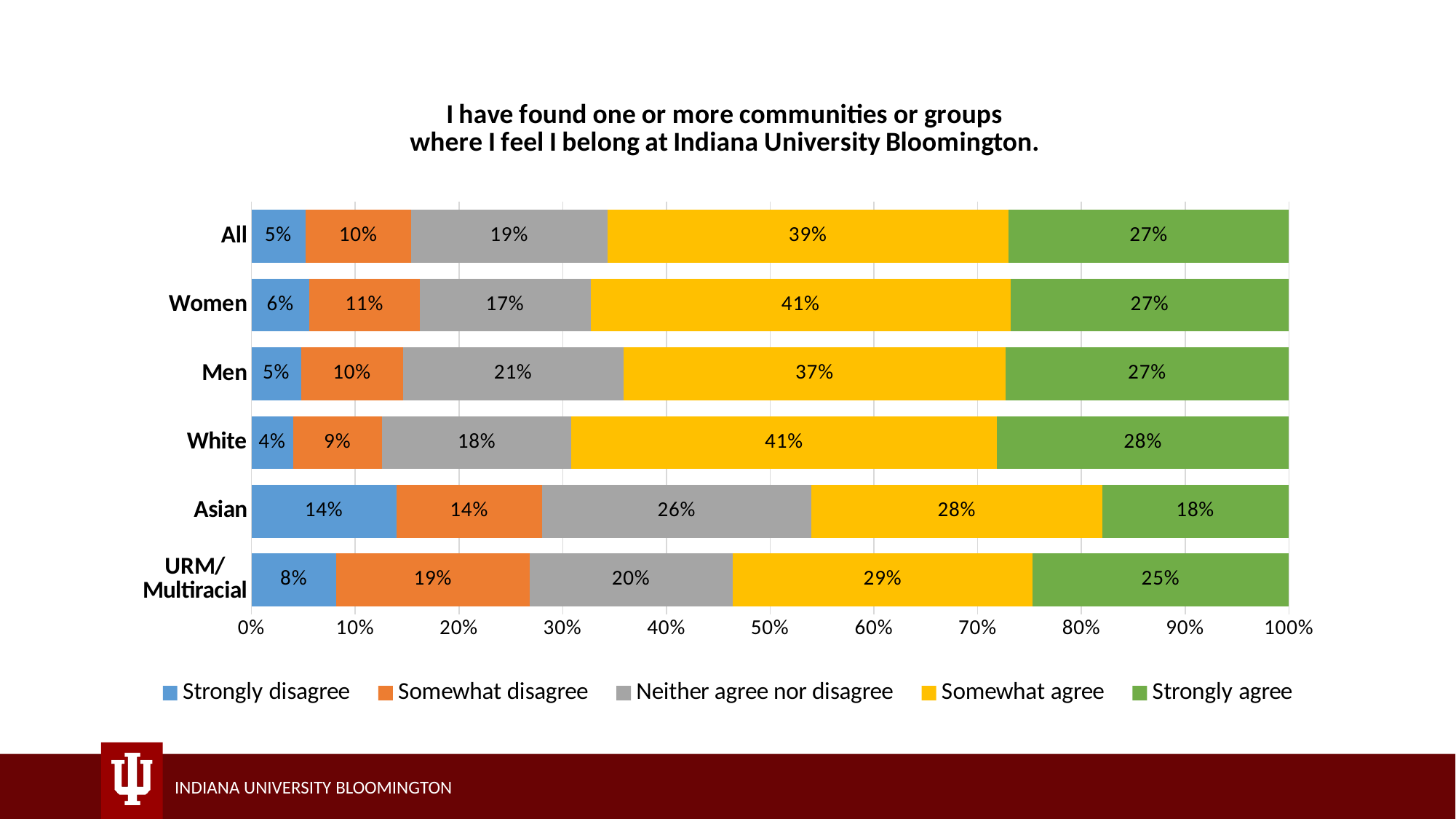
Which group has the lowest Strongly agree percentage? Asian Which colour represents Strongly agree in the legend? Green How many series does the legend list? 5 What is the difference between the Somewhat agree percentage for Women and for Asian respondents? 13% Which group has the highest Strongly agree percentage? White What percentage of Asian respondents strongly disagree? 14% How many groups (categories) are shown on the chart? 6 What percentage of URM/Multiracial respondents somewhat disagree? 19% What percentage of Women somewhat agree? 41% What kind of chart is shown on the slide? Stacked bar chart What is the combined percentage of Somewhat agree and Strongly agree for the All group? 66% Which group has a larger Neither agree nor disagree percentage, Men or White? Men